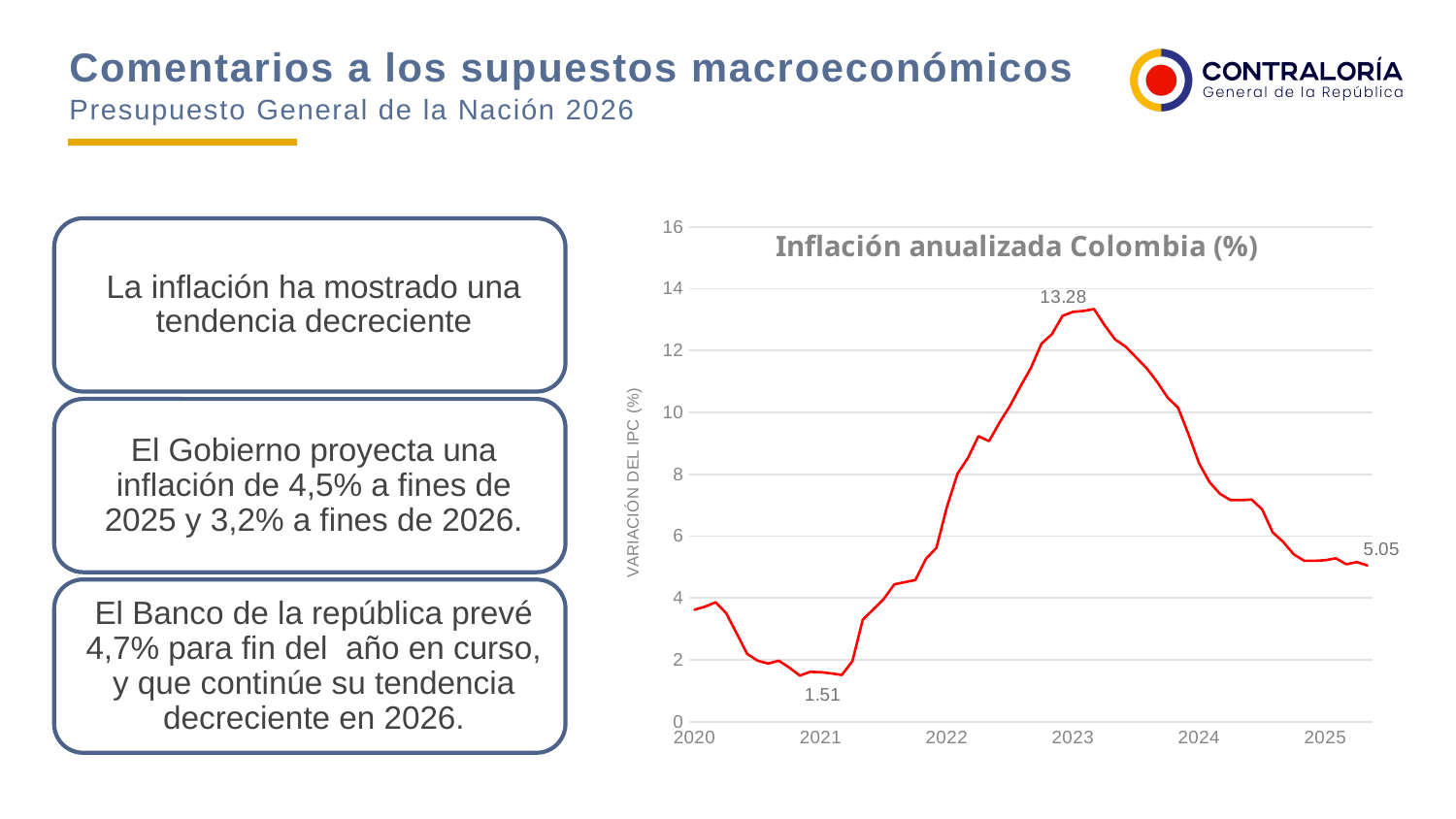
What is the label on the vertical axis of the chart? VARIACIÓN DEL IPC (%) Does the inflation line rise or fall between its 2023 peak and 2025? fall By how much did inflation fall from its peak of 13.28 to the final labeled value of 5.05? 8.23 What is the title of the chart? Inflación anualizada Colombia (%) What is the difference between the peak value (13.28) and the lowest labeled value (1.51)? 11.77 Is the inflation value at the start of 2023 greater or less than 10? greater What is the value labeled at the end of the inflation line, in 2025? 5.05 Which is larger, the inflation value at the start of 2023 or at the start of 2021? 2023 What is the lowest value labeled on the inflation line? 1.51 What kind of chart is shown on the slide? line chart What is the highest value labeled on the inflation line? 13.28 Is the inflation value at the start of 2021 greater or less than 4? less